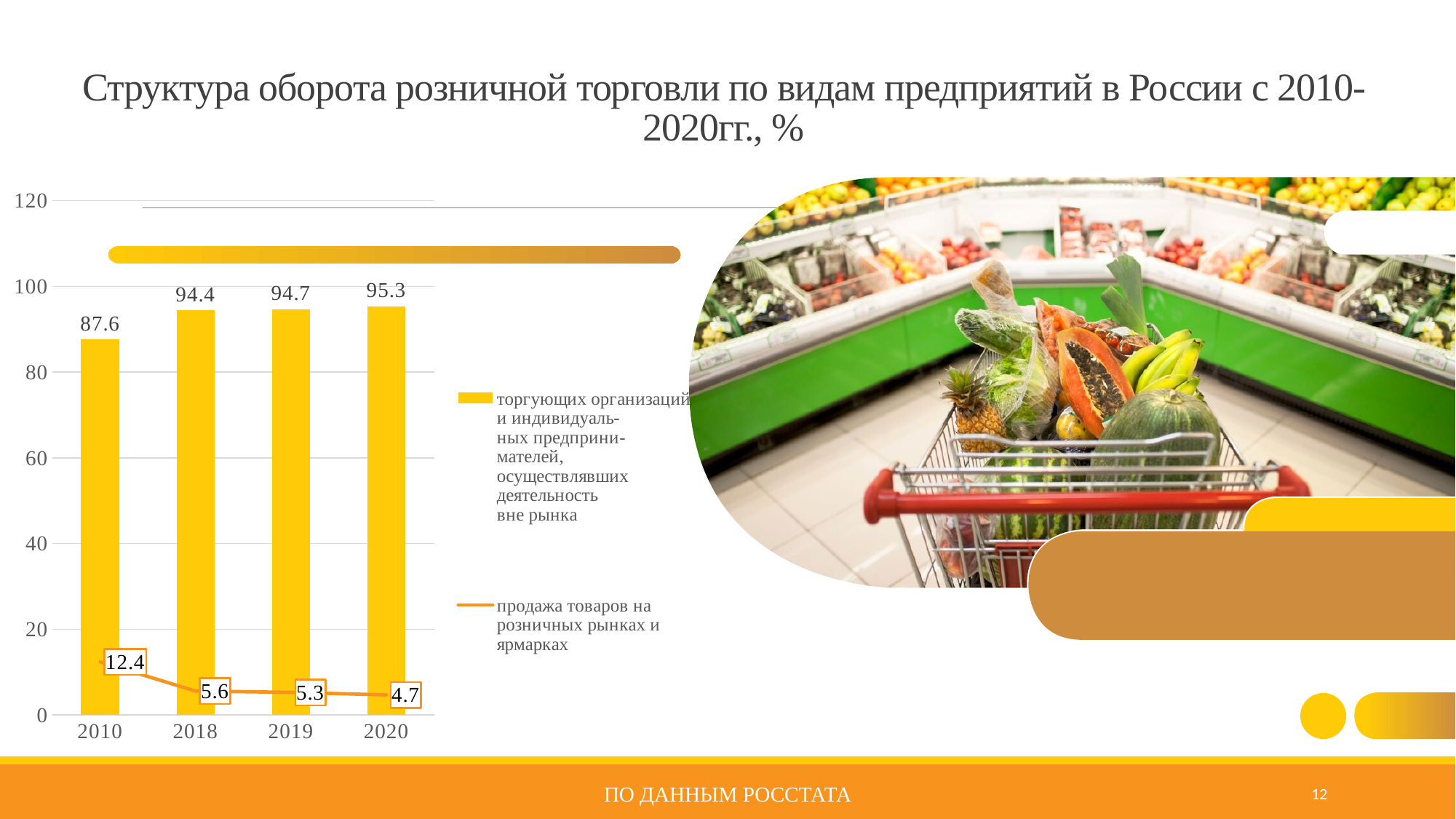
In which year is the line series (продажа товаров на розничных рынках и ярмарках) lowest? 2020 Does the line series (продажа товаров на розничных рынках и ярмарках) rise or fall from 2010 to 2020? fall In which year is the bar series (торгующих организаций) highest? 2020 What is the difference between the bar values for 2020 and 2010? 7.7 What is the value of the line series for 2018? 5.6 What is the value of the bar series for 2019? 94.7 What is the difference between the line values for 2010 and 2018? 6.8 What is the value of the line series (продажа товаров на розничных рынках и ярмарках) for 2020? 4.7 Which is larger: the line value for 2010 or the line value for 2019? 2010 What is the value of the bar series (торгующих организаций и индивидуальных предпринимателей) for 2010? 87.6 How many years are shown on the x axis? 4 How many series does the legend list? 2